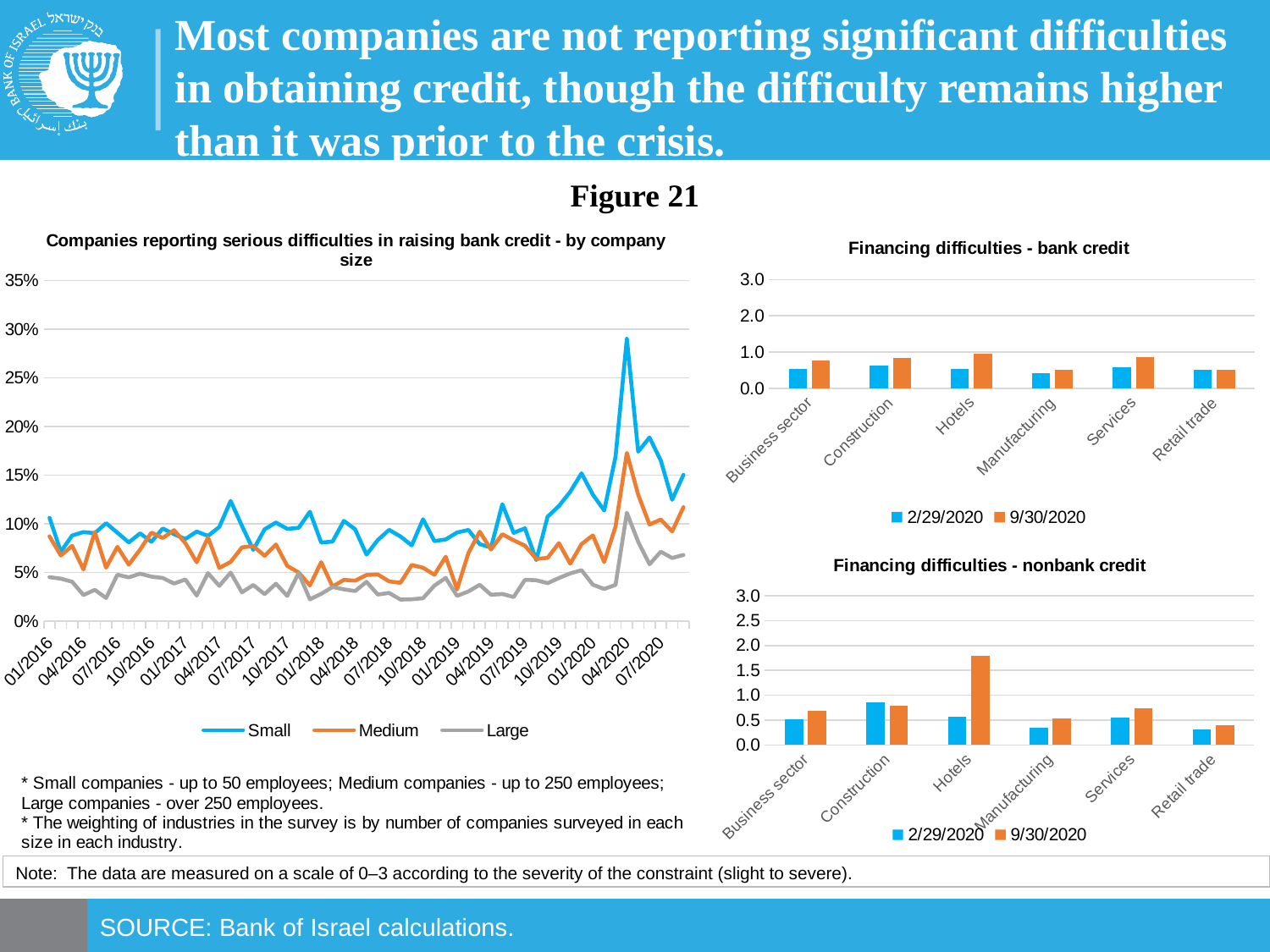
In the left line chart, is the value of the Large series in 04/2020 greater or less than 15%? less How many series does the legend of the left line chart list? 3 In the 'Financing difficulties - nonbank credit' chart, is the value for Hotels on 9/30/2020 greater or less than 1.5? greater In the 'Financing difficulties - nonbank credit' chart, which category has the highest bar for 9/30/2020? Hotels How many series does the legend of the 'Financing difficulties - bank credit' chart list? 2 In the left line chart, which series is larger in 04/2020, Small or Large? Small What kind of chart is the left chart titled 'Companies reporting serious difficulties in raising bank credit - by company size'? line chart In the 'Financing difficulties - bank credit' chart, is the value for Business sector on 2/29/2020 greater or less than 1.0? less What kind of chart is 'Financing difficulties - bank credit'? bar chart In the left line chart, which series reaches the highest value in 04/2020? Small How many categories are shown on the x axis of the 'Financing difficulties - bank credit' chart? 6